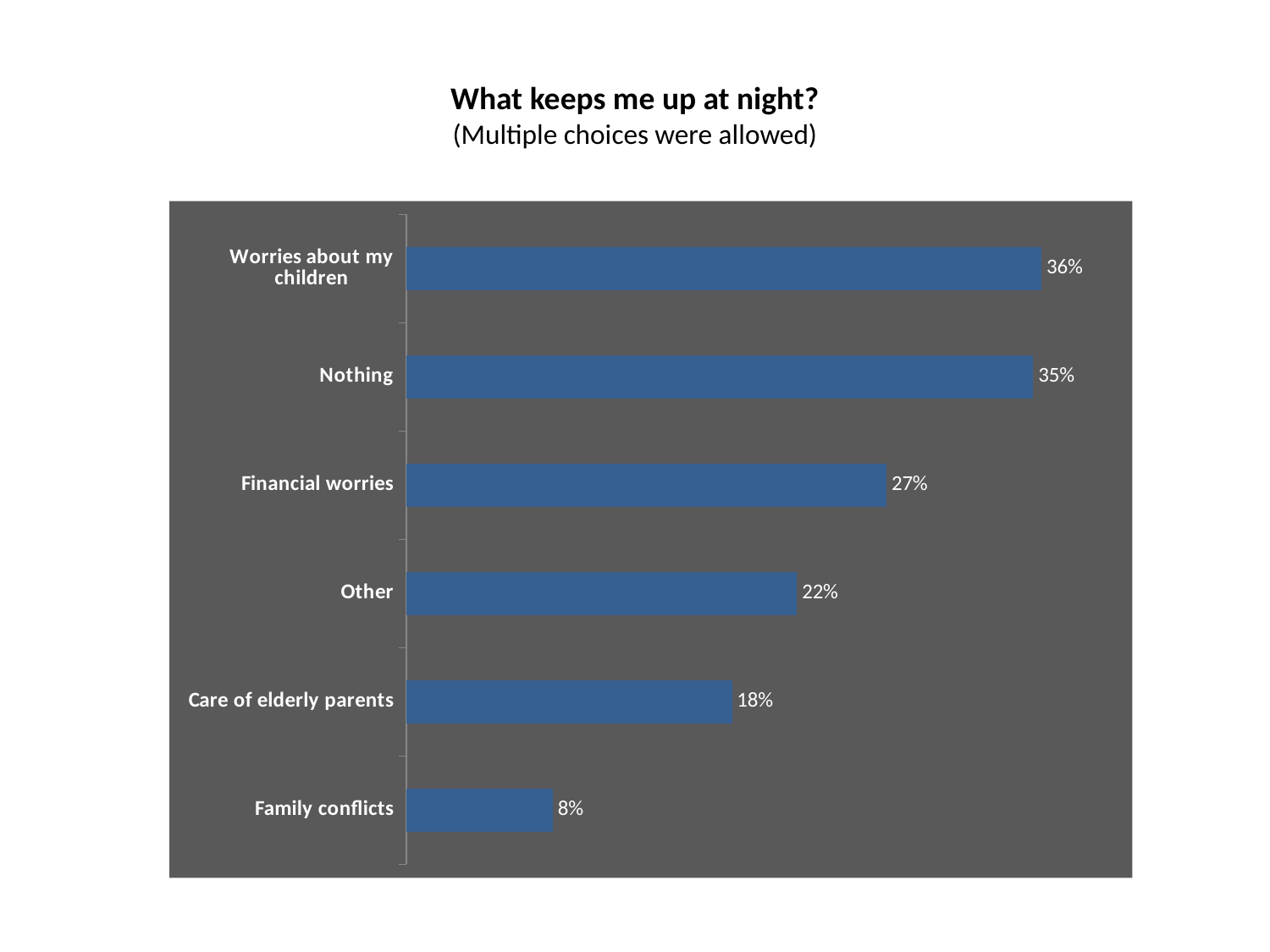
How many categories are shown in the chart? 6 Which category has the highest value? Worries about my children What is the value for Family conflicts? 8% Which category has the lowest value? Family conflicts What is the value for Nothing? 35% What is the value for Financial worries? 27% What is the difference between the values for Financial worries and Other? 5% What is the value for Care of elderly parents? 18% What is the difference between the values for Worries about my children and Family conflicts? 28% What is the title of the chart? What keeps me up at night? Which is larger, the value for Other or the value for Care of elderly parents? Other What kind of chart is shown on the slide? Bar chart